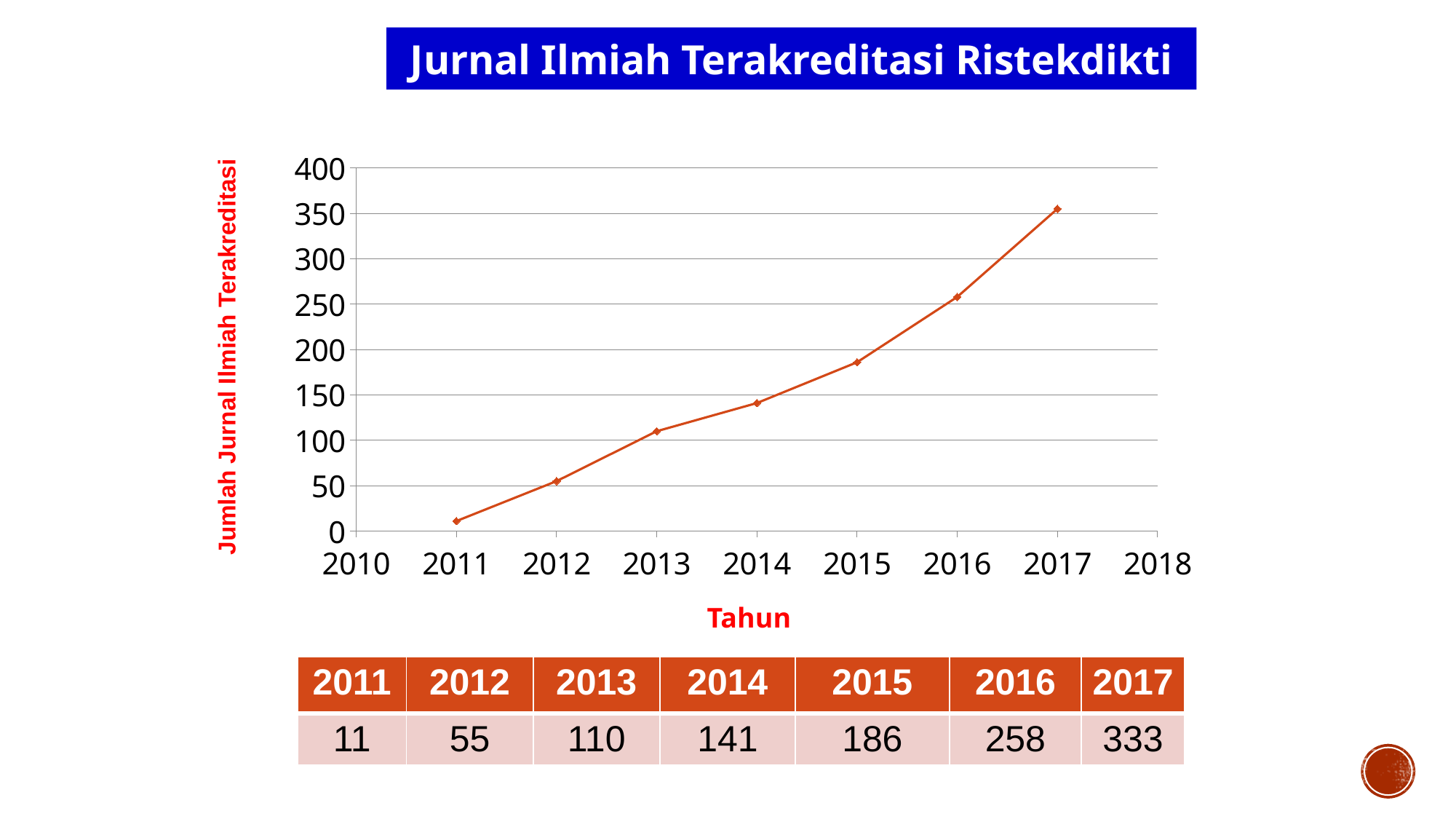
Do the values rise or fall from 2011 to 2017? rise Which year has the highest number of accredited journals? 2017 What is the number of accredited journals in 2011? 11 Which is larger, the value for 2014 or the value for 2013? 2014 Which year has the lowest number of accredited journals? 2011 What kind of chart is shown on the slide? line chart Is the value for 2017 greater or less than 300? greater What is the number of accredited journals in 2013? 110 What is the number of accredited journals in 2016? 258 What is the difference between the values for 2016 and 2015? 72 How many data points are plotted on the line? 7 What is the number of accredited journals in 2015? 186